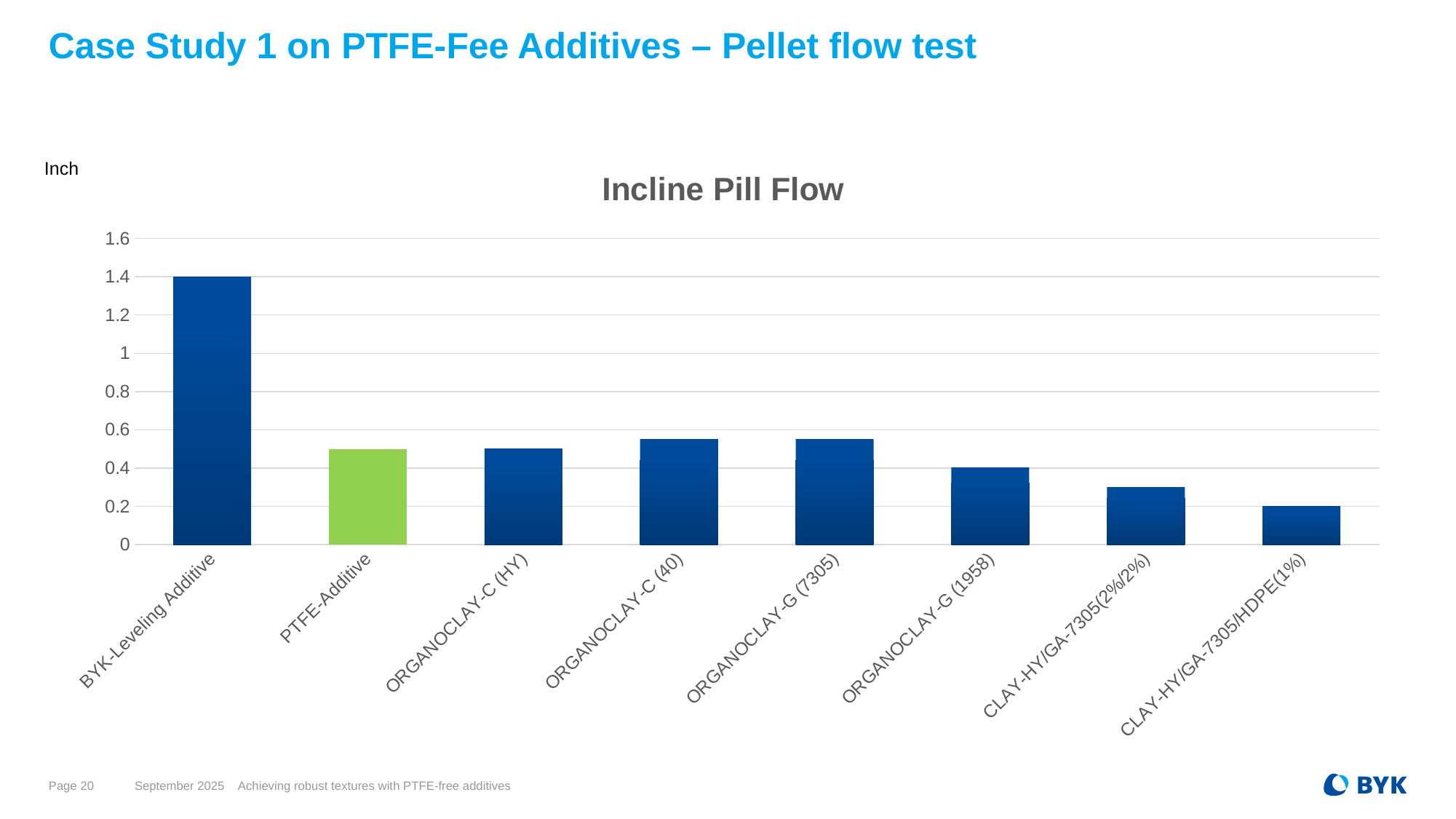
Which category has the lowest value? CLAY-HY/GA-7305/HDPE(1%) Which category has the highest value? BYK-Leveling Additive Which category is shown with a green bar? PTFE-Additive What is the value for BYK-Leveling Additive? 1.4 What is the difference between the values for BYK-Leveling Additive and ORGANOCLAY-G (1958)? 1 How many categories are plotted in the chart? 8 What is the value for CLAY-HY/GA-7305/HDPE(1%)? 0.2 What type of chart is shown on the slide? bar chart What is the title of the chart? Incline Pill Flow Which is larger, the value for ORGANOCLAY-C (40) or the value for ORGANOCLAY-G (1958)? ORGANOCLAY-C (40) What is the value for ORGANOCLAY-G (1958)? 0.4 Is the value for PTFE-Additive greater or less than 0.4? greater